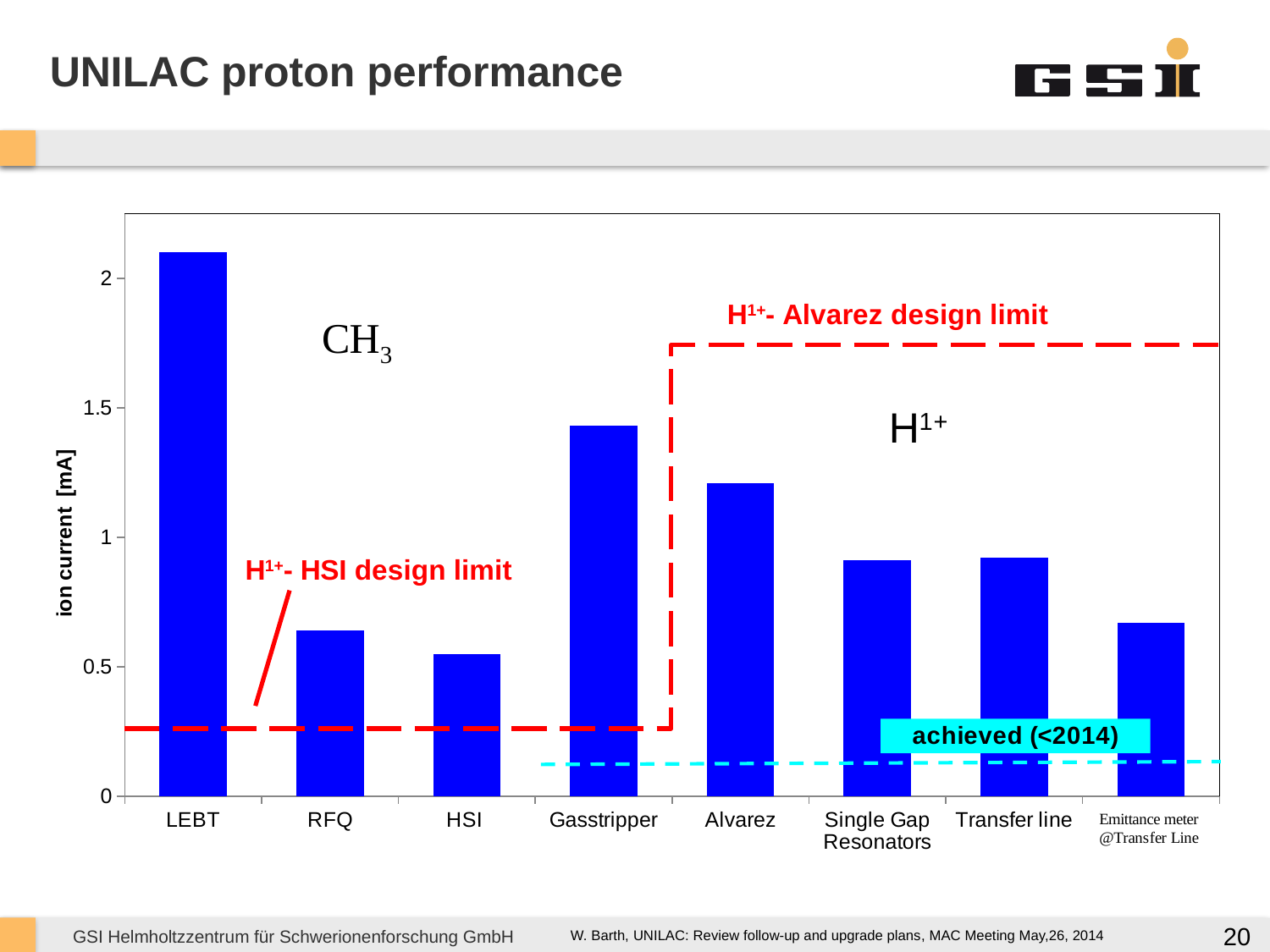
Is the ion current for Single Gap Resonators greater or less than 0.5 mA? greater Is the ion current for HSI greater or less than 1 mA? less How many categories are shown on the x axis of the chart? 8 Is the ion current for Alvarez greater or less than 1.5 mA? less Which has a higher ion current, RFQ or HSI? RFQ What kind of chart is shown on the slide? bar chart Which category has the highest ion current? LEBT Which category has the lowest ion current? HSI Which has a higher ion current, Gasstripper or Alvarez? Gasstripper What is the label of the y axis of the chart? ion current [mA]